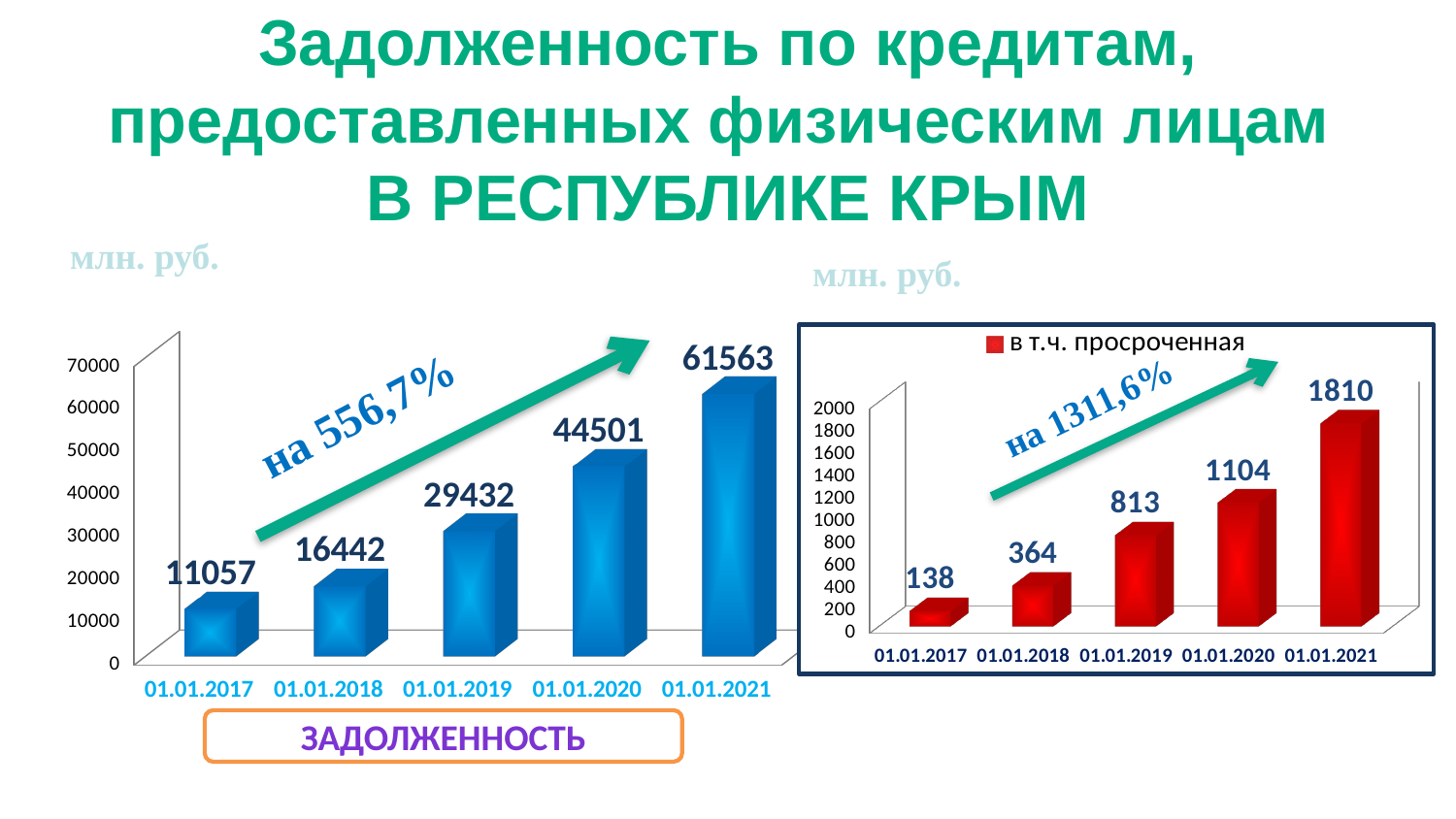
In the right chart (в т.ч. просроченная), what is the difference between the values for 01.01.2019 and 01.01.2018? 449 In the right chart (в т.ч. просроченная), is the value for 01.01.2021 greater or less than 1600? greater How many dates are shown on the x axis of the left chart (ЗАДОЛЖЕННОСТЬ)? 5 What legend entry is shown above the right chart? в т.ч. просроченная In the right chart (в т.ч. просроченная), what is the value for 01.01.2020? 1104 In the left chart (ЗАДОЛЖЕННОСТЬ), which is larger: the value for 01.01.2018 or 01.01.2019? 01.01.2019 In the left chart (ЗАДОЛЖЕННОСТЬ), which date has the highest value? 01.01.2021 What kind of chart is the right chart (в т.ч. просроченная)? bar chart In the left chart (ЗАДОЛЖЕННОСТЬ), what is the difference between the values for 01.01.2021 and 01.01.2020? 17062 In the right chart (в т.ч. просроченная), which date has the lowest value? 01.01.2017 In the left chart (ЗАДОЛЖЕННОСТЬ), do the values rise or fall from 01.01.2017 to 01.01.2021? rise In the left chart (ЗАДОЛЖЕННОСТЬ), what is the value for 01.01.2019? 29432